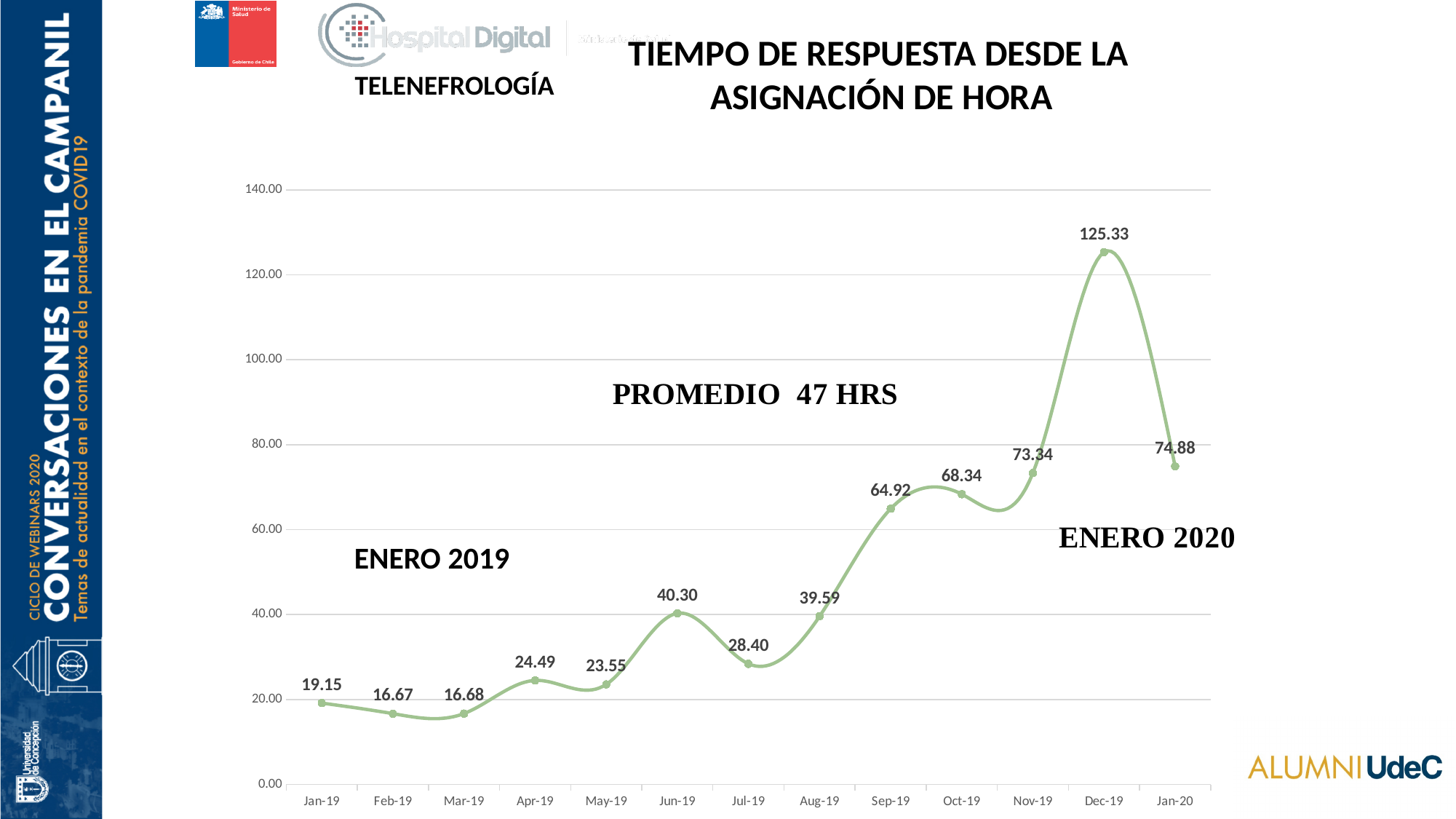
What is the value for Jun-19? 40.30 Is the value for Nov-19 greater or less than 80? less What is the value for Jan-20? 74.88 Which is larger, the value for Sep-19 or the value for Oct-19? Oct-19 What is the difference between the values for Jan-20 and Jan-19? 55.73 What kind of chart is shown on the slide? line chart What is the title of the chart? TIEMPO DE RESPUESTA DESDE LA ASIGNACIÓN DE HORA What is the difference between the values for Dec-19 and Jan-20? 50.45 What is the value for Dec-19? 125.33 How many months are plotted on the x axis? 13 Which month has the highest value? Dec-19 What is the value for Jan-19? 19.15